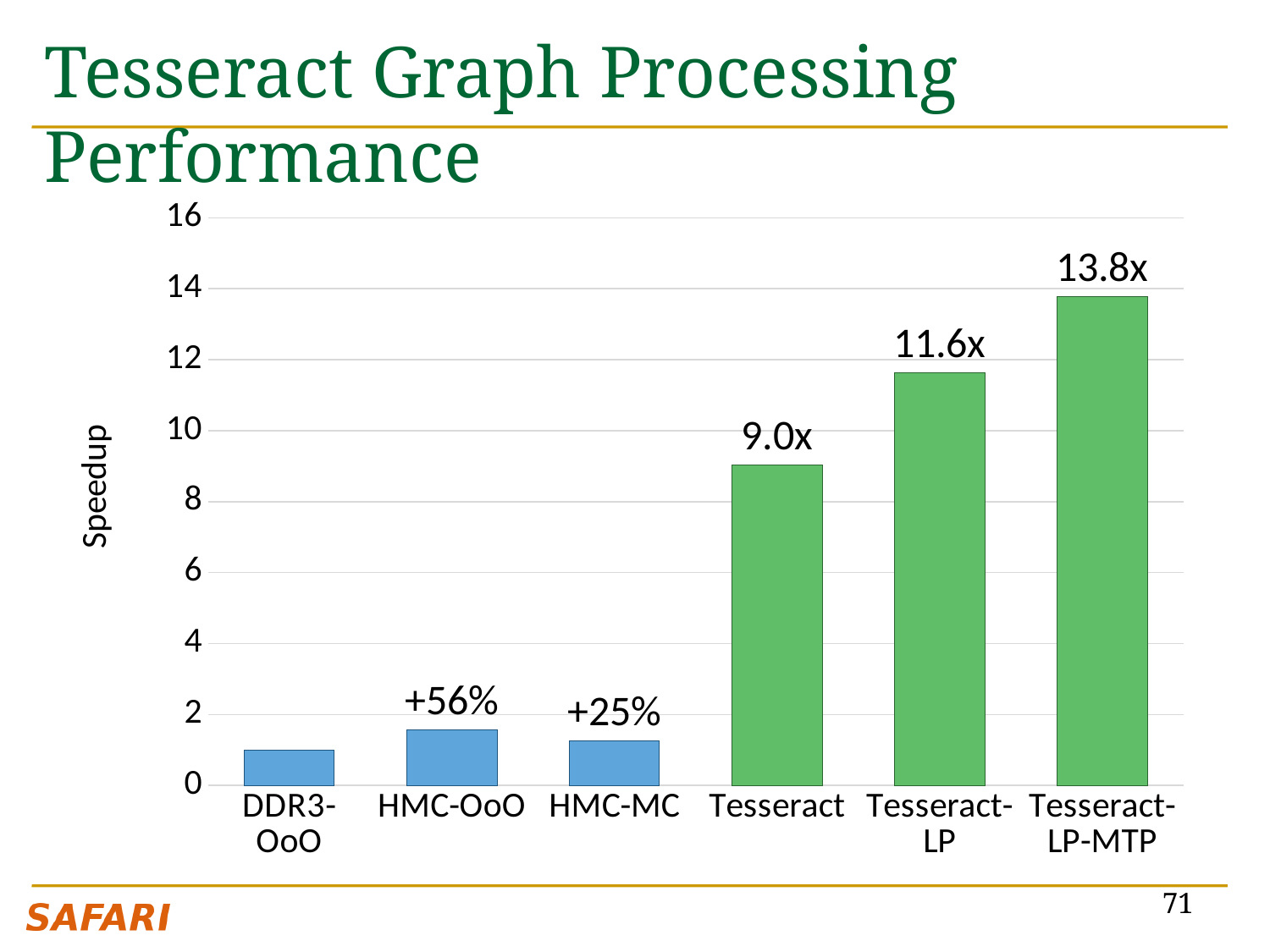
What is the speedup value shown for Tesseract-LP-MTP? 13.8x What is the label on the y axis? Speedup Is the value for DDR3-OoO greater or less than 2? less What kind of chart is shown on the slide? Bar chart How many categories are shown on the x axis? 6 What is the speedup value shown for Tesseract-LP? 11.6x Which has a larger speedup, HMC-OoO or HMC-MC? HMC-OoO What is the difference between the speedup of Tesseract-LP-MTP and Tesseract? 4.8x Which category has the highest speedup? Tesseract-LP-MTP What is the speedup value shown for Tesseract? 9.0x Which category has the lowest speedup? DDR3-OoO Do the values generally rise or fall from left to right across the three Tesseract bars? Rise